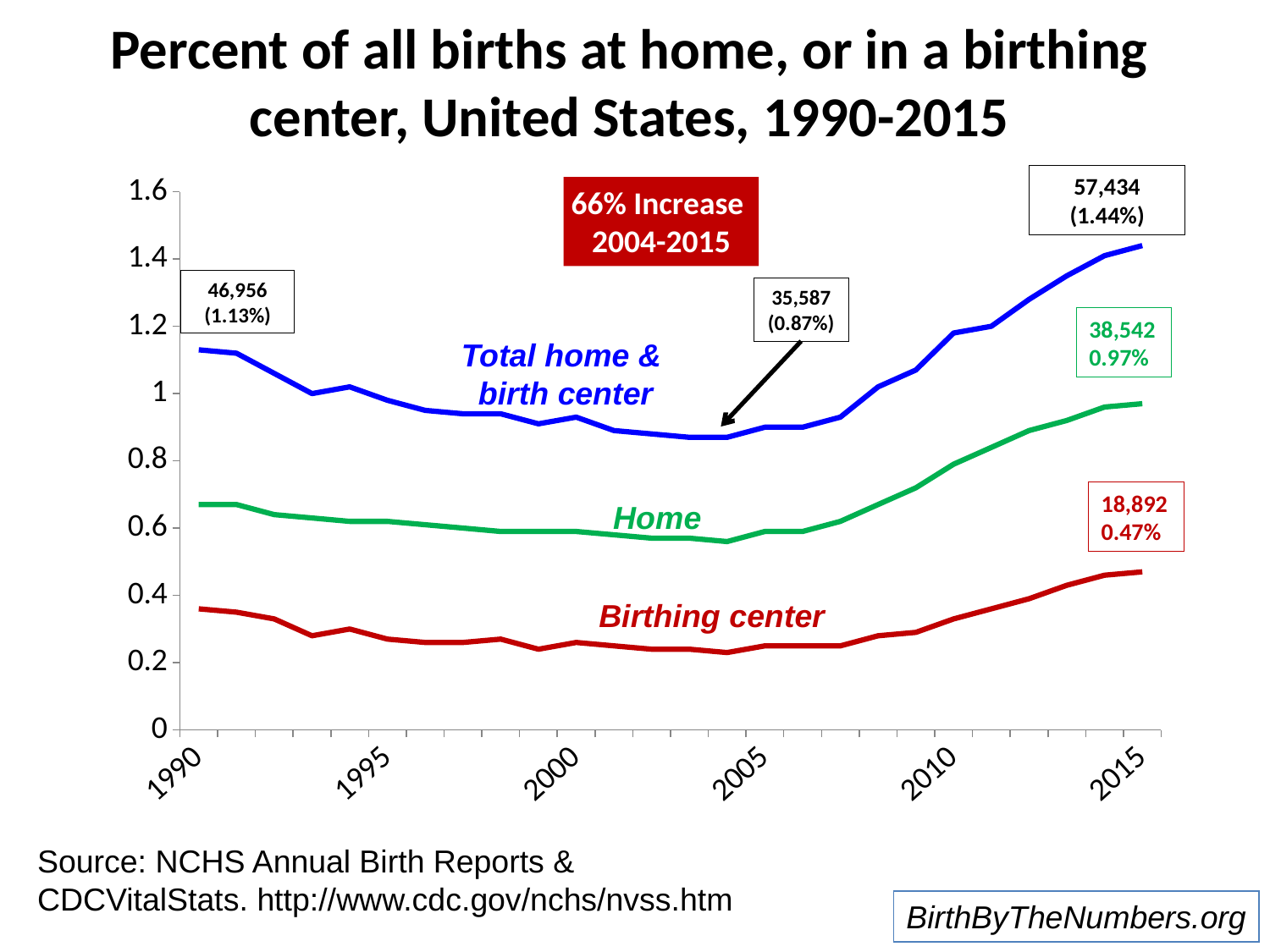
Is the value for Birthing center in 2004 greater or less than 0.4? less Does the Total home & birth center series rise or fall from 2004 to 2015? rise What percent increase does the red box on the chart report for 2004-2015? 66% Increase Is the value for Home in 1990 greater or less than 0.6? greater What number of births is labeled for the Home series in 2015? 38,542 What percentage is labeled for the Total home & birth center series in 2004? 0.87% What number of births is labeled for the Total home & birth center series in 1990? 46,956 Which series has the lowest values across the whole period? Birthing center What percentage is labeled for the Total home & birth center series in 2015? 1.44% How many series are plotted on the chart? 3 What percentage is labeled for the Birthing center series in 2015? 0.47% What kind of chart is shown on the slide? line chart